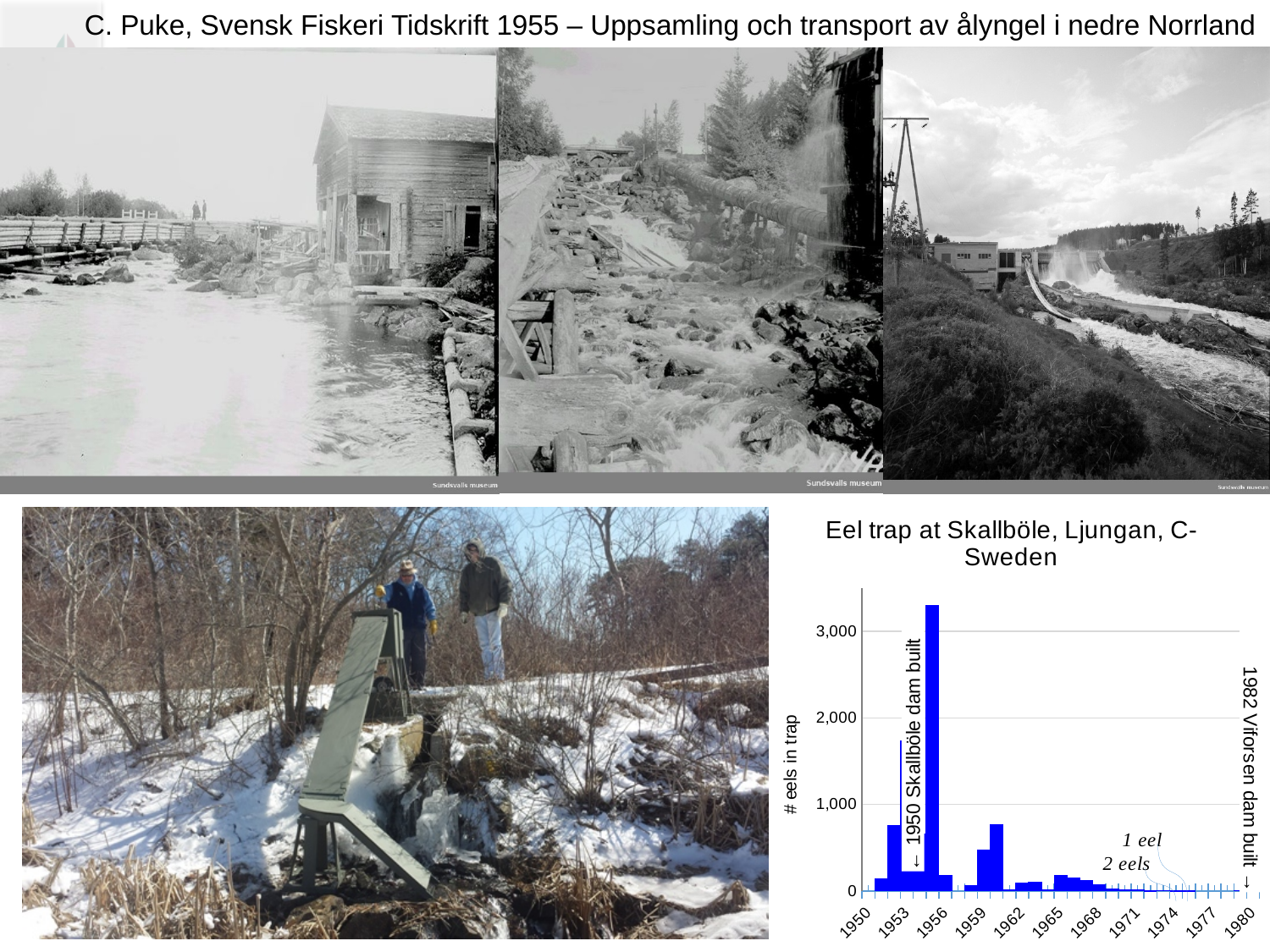
Overall, do the number of eels in the trap rise or fall from the mid-1950s to 1980? fall Which is larger, the value for 1953 or the value for 1965? 1953 Is the value for 1965 greater or less than 1,000? less Which is larger, the value for 1968 or the value for 1977? 1968 Is the value for 1959 greater or less than 2,000? less Is the tallest bar in the chart greater or less than 3,000? greater What kind of chart is shown on the slide? Bar chart What is the title of the chart? Eel trap at Skallböle, Ljungan, C-Sweden What is the label on the vertical axis of the chart? # eels in trap What is the highest tick value shown on the vertical axis? 3,000 How many year labels are shown on the x axis of the chart? 11